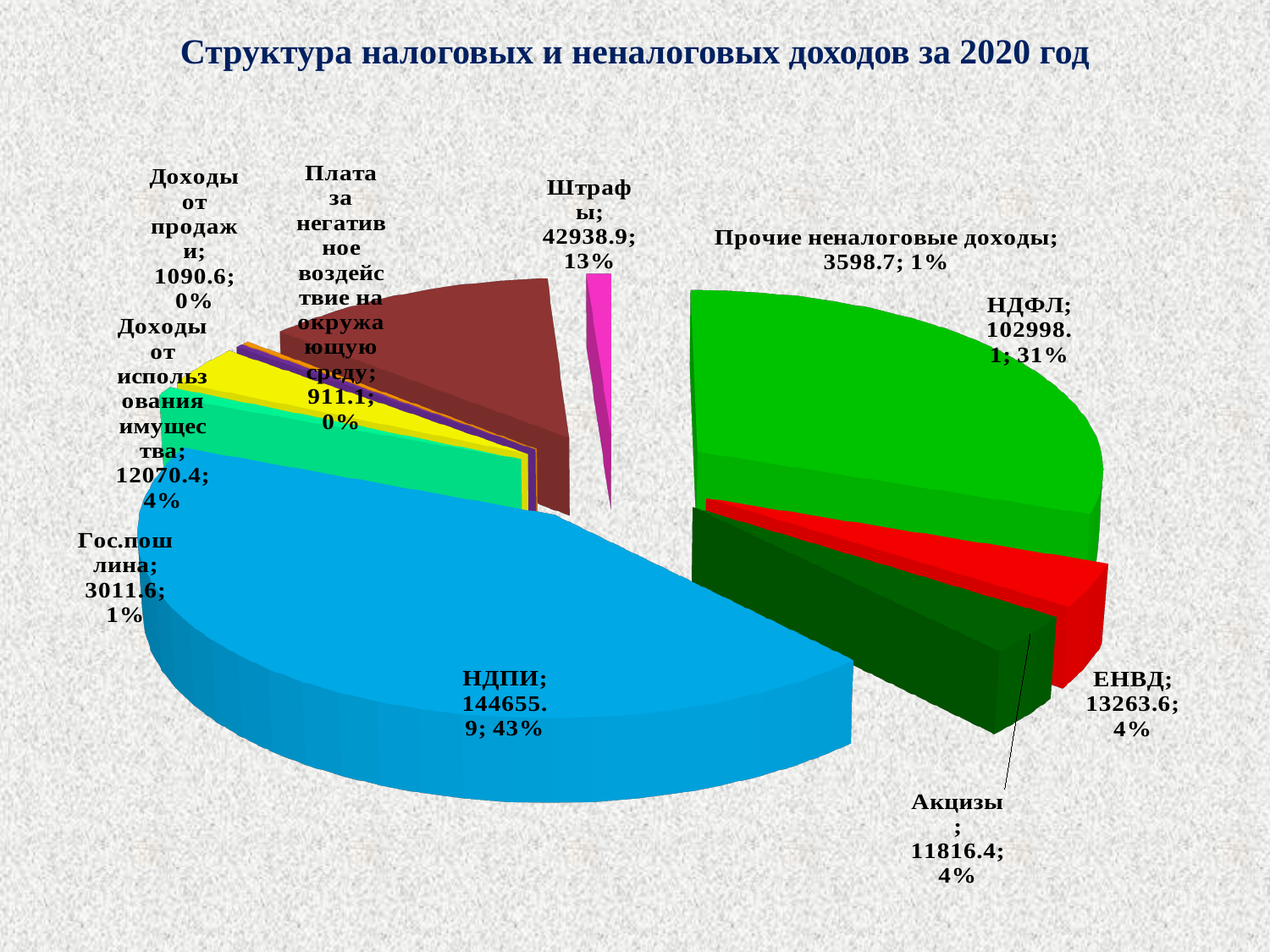
What is the value for Доходы от использования имущества? 12070.4 What is the value for Штрафы? 42938.9 What share of the pie does Штрафы represent? 13% Which category has the smallest value? Плата за негативное воздействие на окружающую среду Which is larger, the value for Гос.пошлина or the value for Прочие неналоговые доходы? Прочие неналоговые доходы What kind of chart is shown on the slide? pie chart How many categories are shown in the pie chart? 10 What is the title of the chart? Структура налоговых и неналоговых доходов за 2020 год What is the value for НДПИ? 144655.9 What share of the pie does НДФЛ represent? 31% What is the difference between the values for ЕНВД and Акцизы? 1447.2 Which category has the largest slice of the pie? НДПИ